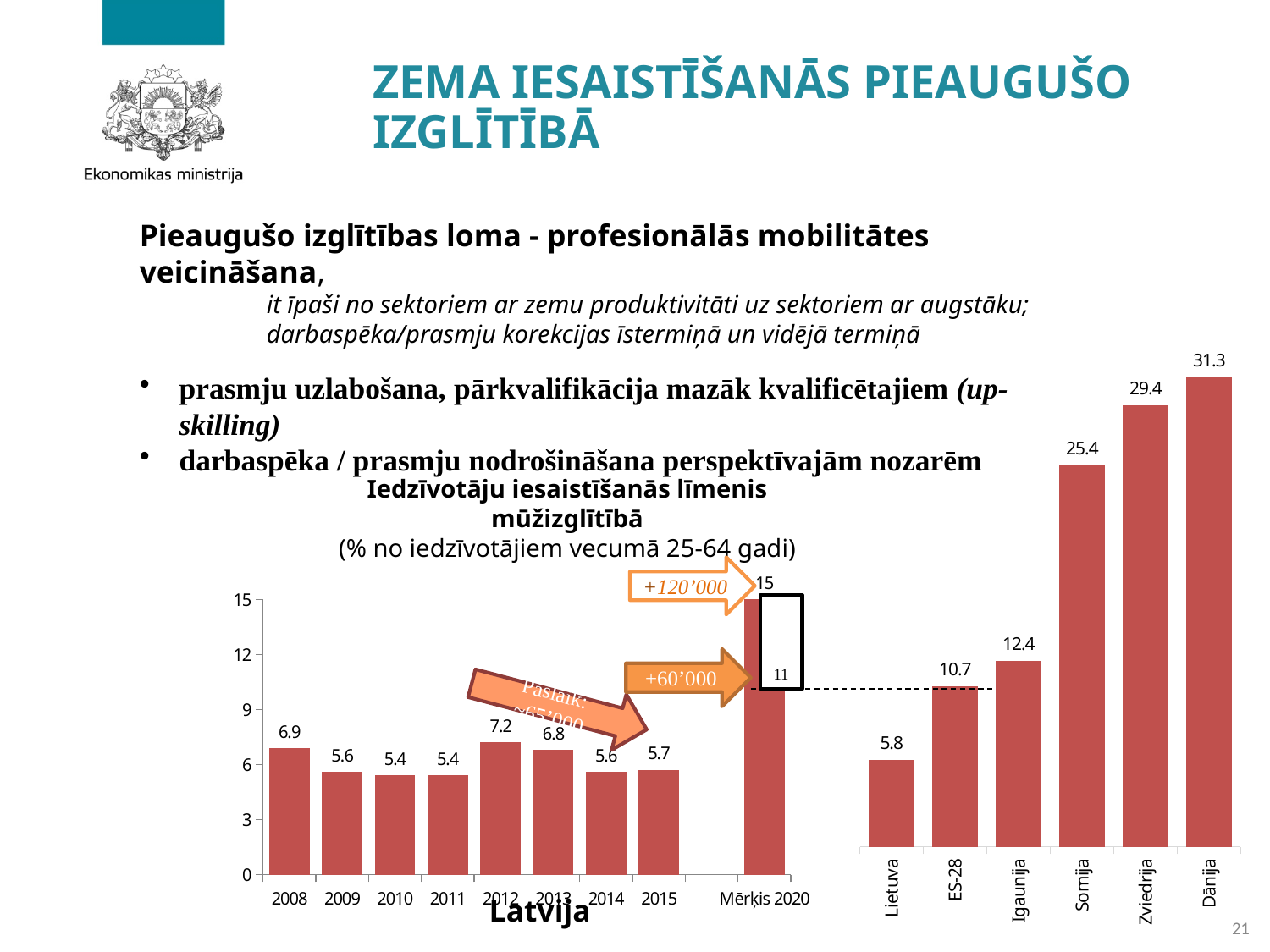
In the right chart, what is the difference between the values for Dānija and Zviedrija? 1.9 In the left chart (Latvija), what is the value for 2015? 5.7 In the right chart, what is the value for ES-28? 10.7 In the left chart (Latvija), which year between 2008 and 2015 has the highest value? 2012 In the left chart (Latvija), what is the value shown for Mērķis 2020? 15 In the right chart, which is larger, the value for Igaunija or the value for ES-28? Igaunija In the left chart (Latvija), is the value for 2013 greater or less than 6? greater In the left chart (Latvija), what is the difference between the 2012 value and the 2011 value? 1.8 In the right chart, which country has the lowest value? Lietuva What type of chart is the left chart (Latvija)? Bar chart In the left chart (Latvija), what is the value for 2008? 6.9 In the right chart, which country has the highest value? Dānija